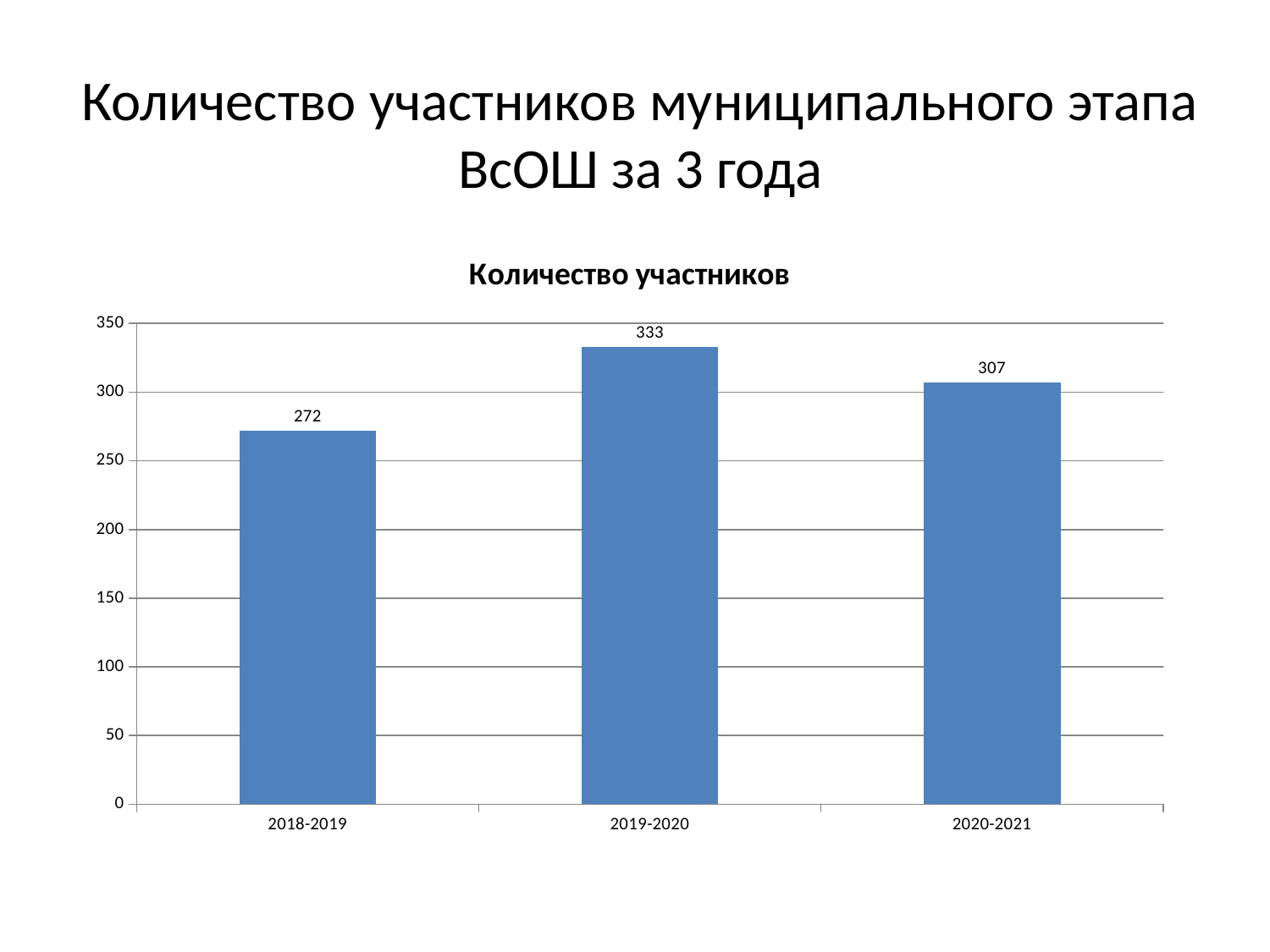
How many years are shown on the chart? 3 What is the difference in participants between 2019-2020 and 2018-2019? 61 Which year has the lowest number of participants? 2018-2019 What is the title of the chart? Количество участников What is the number of participants for 2018-2019? 272 Is the value for 2018-2019 greater or less than 300? less Which year has more participants, 2020-2021 or 2018-2019? 2020-2021 Which year has the highest number of participants? 2019-2020 What is the number of participants for 2020-2021? 307 What is the difference in participants between 2019-2020 and 2020-2021? 26 What kind of chart is shown on the slide? bar chart What is the number of participants for 2019-2020? 333